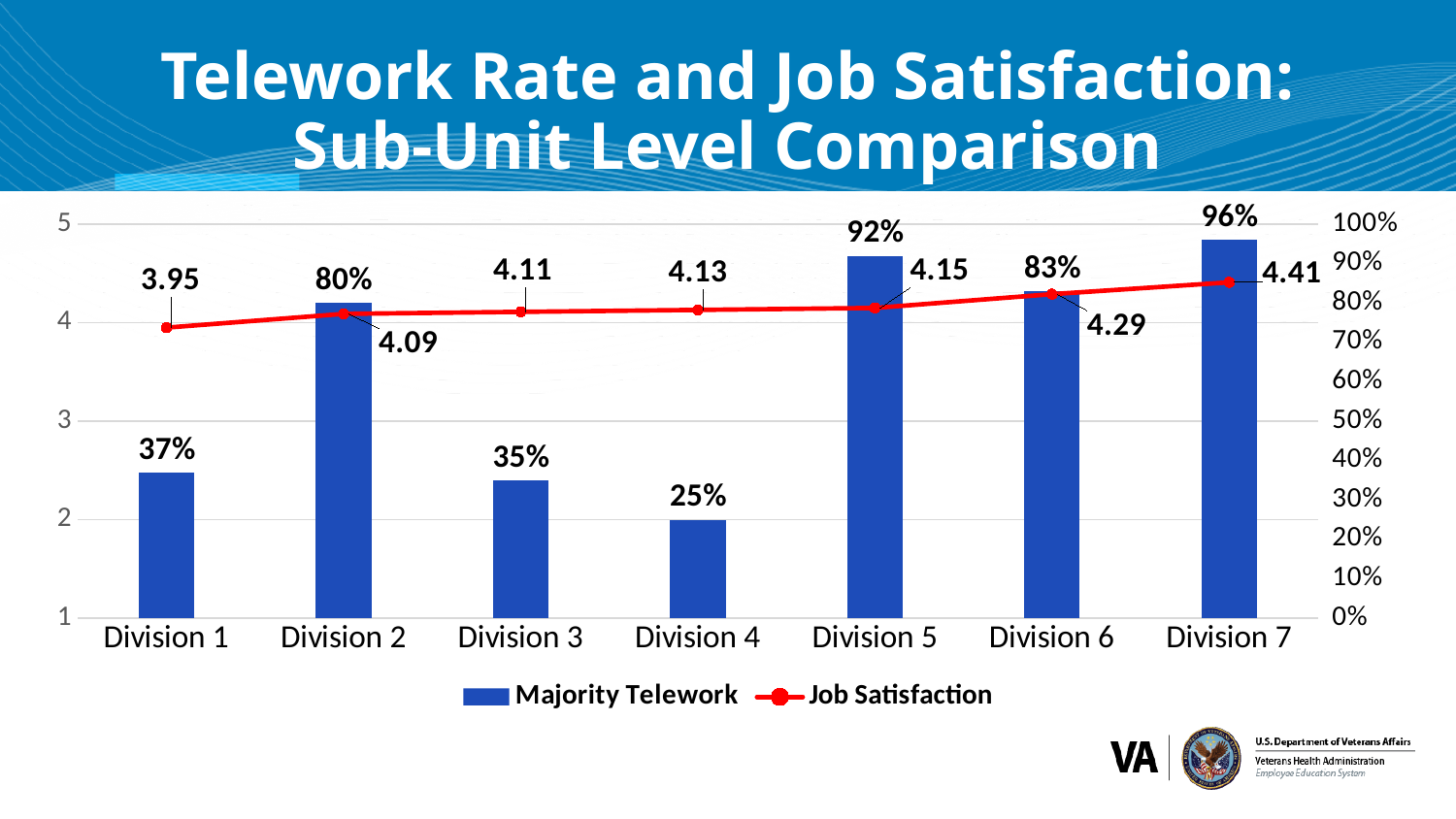
What is the Majority Telework value for Division 5? 92% How many series does the legend list? 2 Which division has the highest Majority Telework value? Division 7 Which division has the lowest Job Satisfaction value? Division 1 What colour is the Job Satisfaction line? Red What is the difference between the Job Satisfaction values for Division 7 and Division 1? 0.46 What is the Job Satisfaction value for Division 6? 4.29 What is the difference between the Majority Telework values for Division 7 and Division 4? 71% How many divisions are shown on the x axis? 7 What is the Job Satisfaction value for Division 1? 3.95 Which has a higher Majority Telework value, Division 1 or Division 3? Division 1 Which division has the lowest Majority Telework value? Division 4